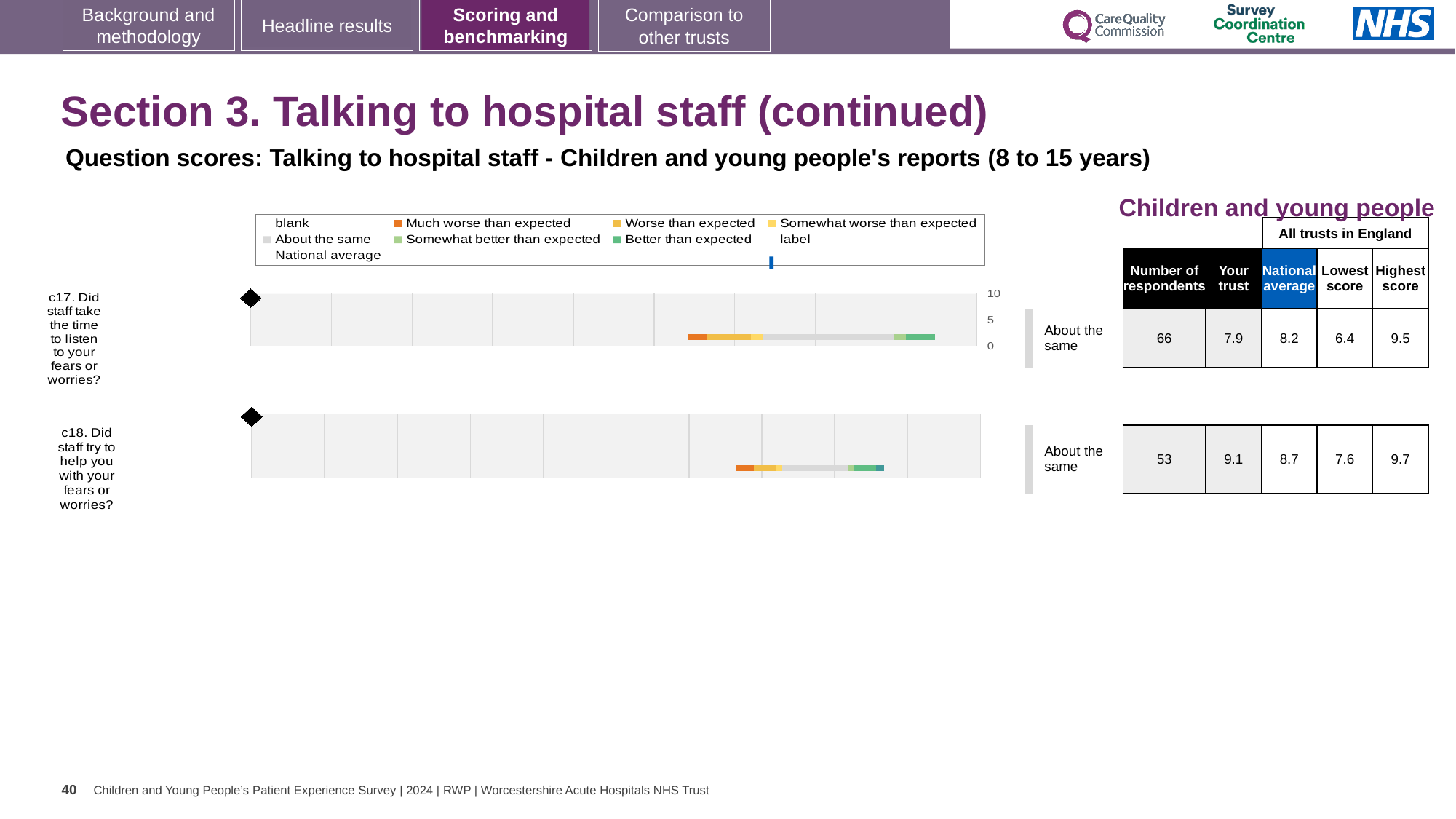
What is the highest score across all trusts in England for c18? 9.7 What benchmark category is shown for c18? About the same What type of chart is used to show the question scores for c17 and c18? bar chart What is the 'Your trust' score for c18 (Did staff try to help you with your fears or worries?)? 9.1 Is the trust score for c17 greater or less than 5? greater What is the difference between the highest score and the lowest score for c17? 3.1 What is the 'Your trust' score for c17 (Did staff take the time to listen to your fears or worries?)? 7.9 How many respondents answered c17? 66 What is the national average for c17? 8.2 How many questions (categories) are plotted on the slide? 2 By how much does the trust score for c18 exceed the national average for c18? 0.4 Which question has the higher 'Your trust' score, c17 or c18? c18